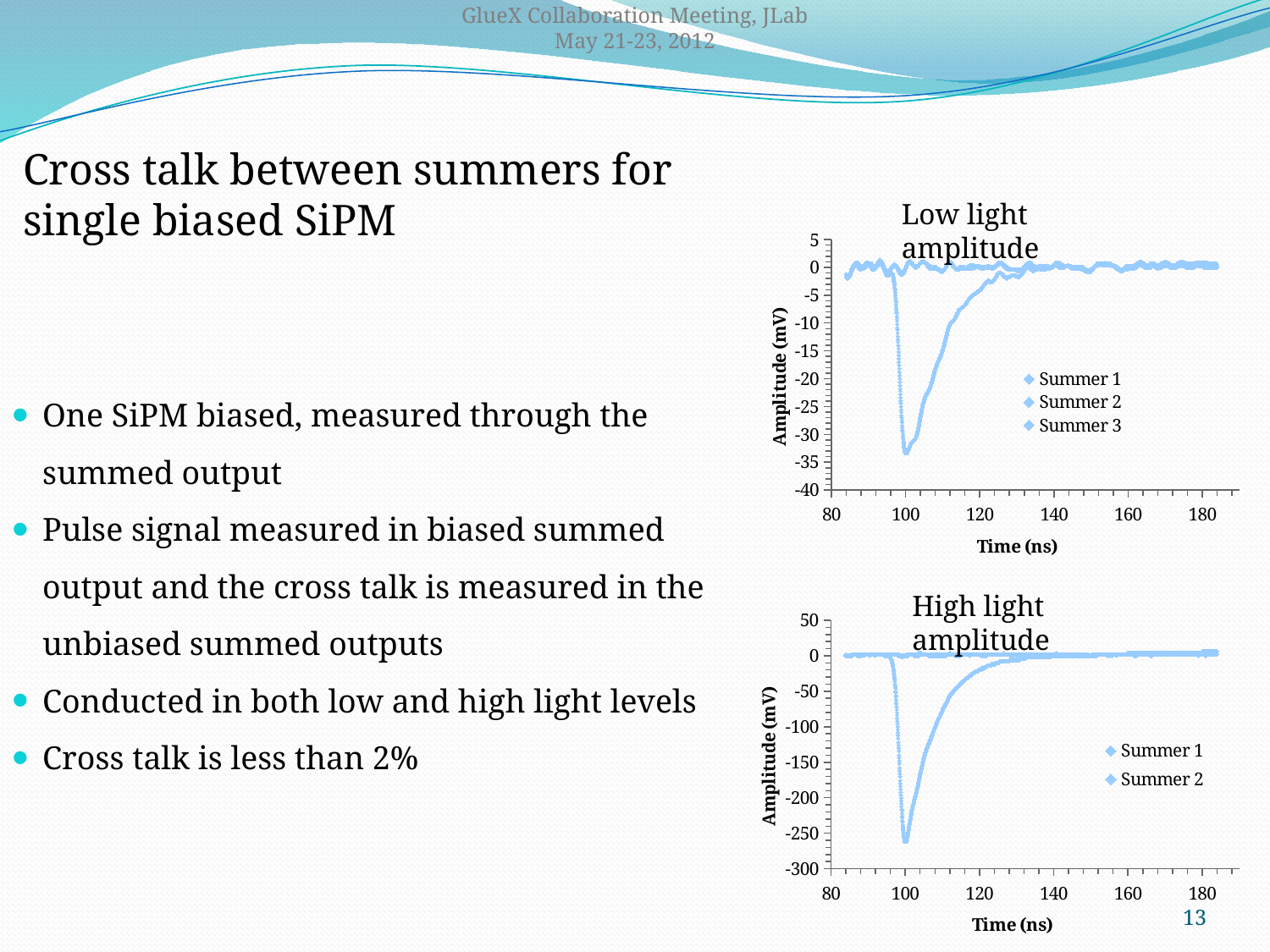
What kind of chart is the "Low light amplitude" chart? Scatter chart What kind of chart is the "High light amplitude" chart? Scatter chart How many series does the legend of the "Low light amplitude" chart list? 3 In the "Low light amplitude" chart, is the minimum amplitude of the pulse greater or less than -20 mV? less How many series does the legend of the "High light amplitude" chart list? 2 In the "High light amplitude" chart, at roughly what time on the x axis does the pulse reach its minimum: closer to 100 ns or 140 ns? 100 ns In the "Low light amplitude" chart, is the minimum amplitude of the pulse greater or less than -40 mV? greater In the "Low light amplitude" chart, at roughly what time on the x axis does the pulse reach its minimum: closer to 100 ns or 160 ns? 100 ns In the "High light amplitude" chart, is the minimum amplitude of the pulse greater or less than -200 mV? less What is the x-axis label of the "High light amplitude" chart? Time (ns) What is the y-axis label of the "Low light amplitude" chart? Amplitude (mV)